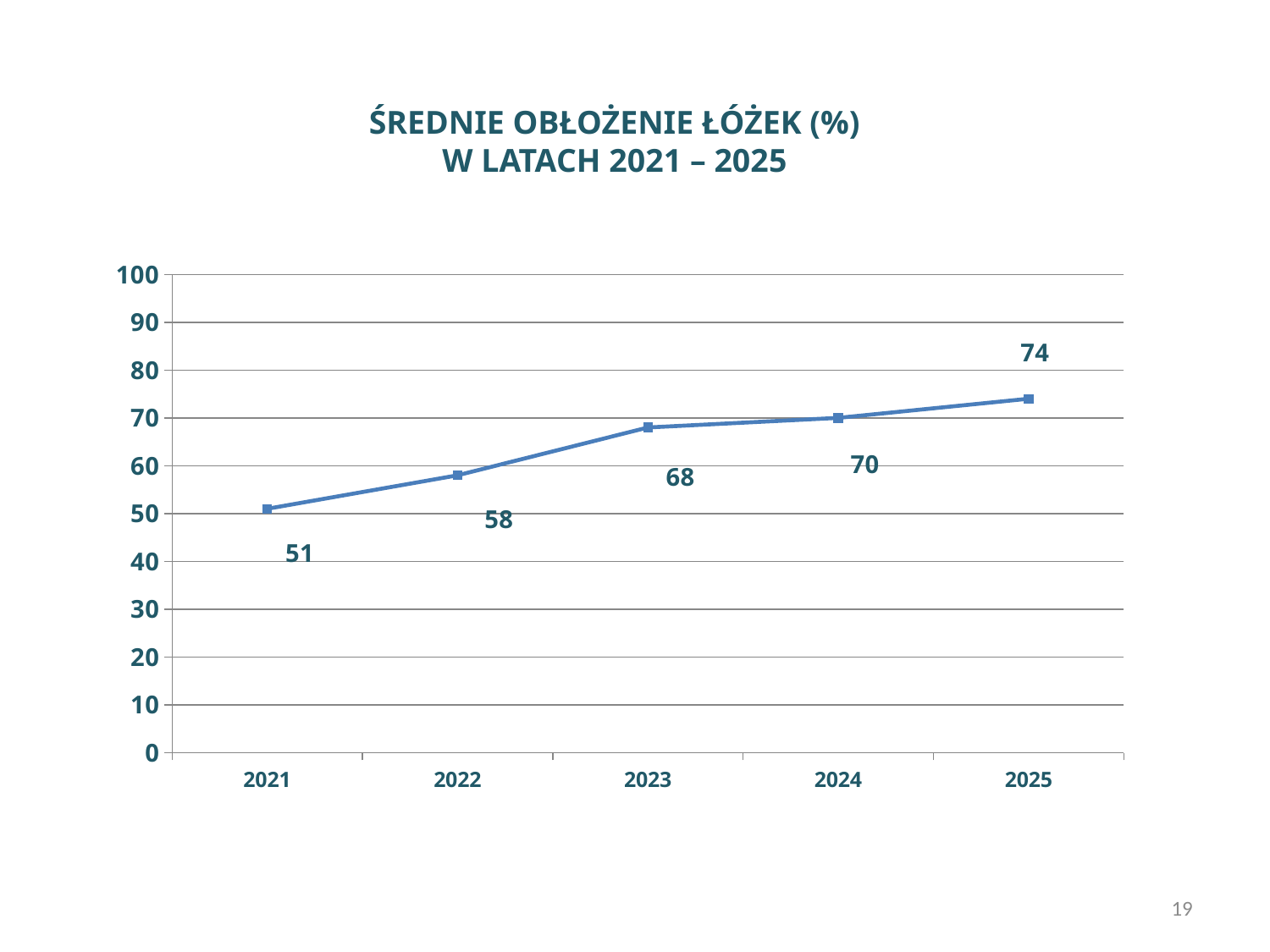
What is the average bed occupancy value for 2021? 51 What is the difference between the values for 2025 and 2021? 23 What is the difference between the values for 2023 and 2022? 10 Is the value for 2022 greater or less than 50? greater What is the value plotted for 2023? 68 Which year has the larger value, 2022 or 2024? 2024 Which year has the lowest average bed occupancy? 2021 What kind of chart is shown on the slide? line chart What is the value plotted for 2025? 74 Which year has the highest average bed occupancy? 2025 Do the values rise or fall from 2021 to 2025? rise How many years are plotted on the chart? 5